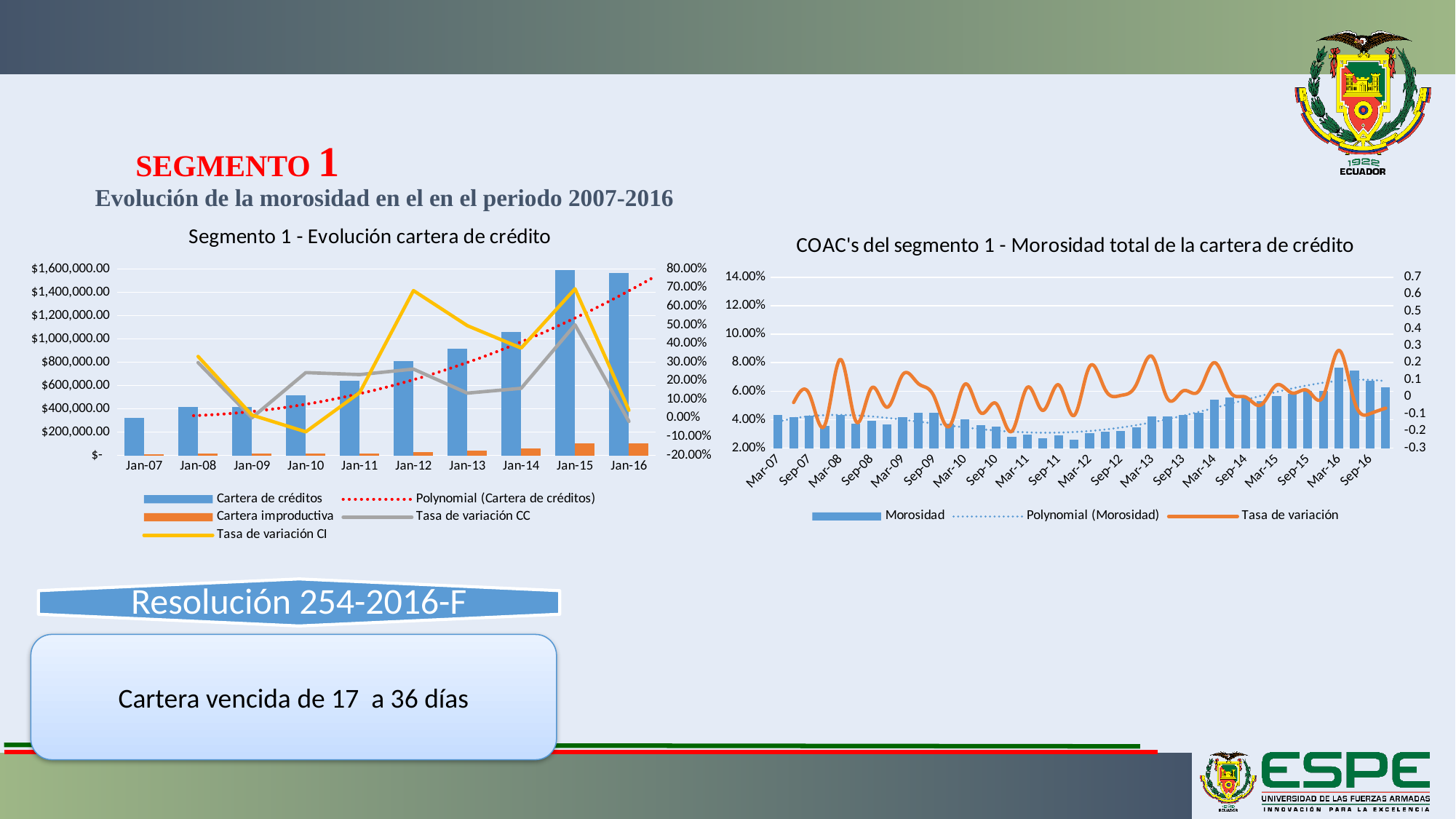
In the chart titled 'Segmento 1 - Evolución cartera de crédito', which year has the lowest Cartera de créditos bar? Jan-07 In the chart titled 'Segmento 1 - Evolución cartera de crédito', how many categories are shown on the x axis? 10 In the chart titled 'Segmento 1 - Evolución cartera de crédito', do the Cartera de créditos bars generally rise or fall from Jan-07 to Jan-15? rise In the chart titled 'Segmento 1 - Evolución cartera de crédito', what kind of chart is it? bar and line chart In the chart titled 'Segmento 1 - Evolución cartera de crédito', is the Cartera de créditos value for Jan-07 greater or less than $400,000.00? less In the chart titled 'Segmento 1 - Evolución cartera de crédito', is the Cartera de créditos value for Jan-15 greater or less than $1,400,000.00? greater In the chart titled 'Segmento 1 - Evolución cartera de crédito', which series is drawn as orange bars? Cartera improductiva In the chart titled 'Segmento 1 - Evolución cartera de crédito', how many series does the legend list? 5 In the chart titled 'Segmento 1 - Evolución cartera de crédito', which is larger, the Cartera de créditos bar for Jan-13 or for Jan-14? Jan-14 In the chart on the right, how many series does the legend list? 3 In the chart on the right, which period has the highest Morosidad bar? Mar-16 In the chart on the right, is the Morosidad value for Mar-07 greater or less than 6.00%? less